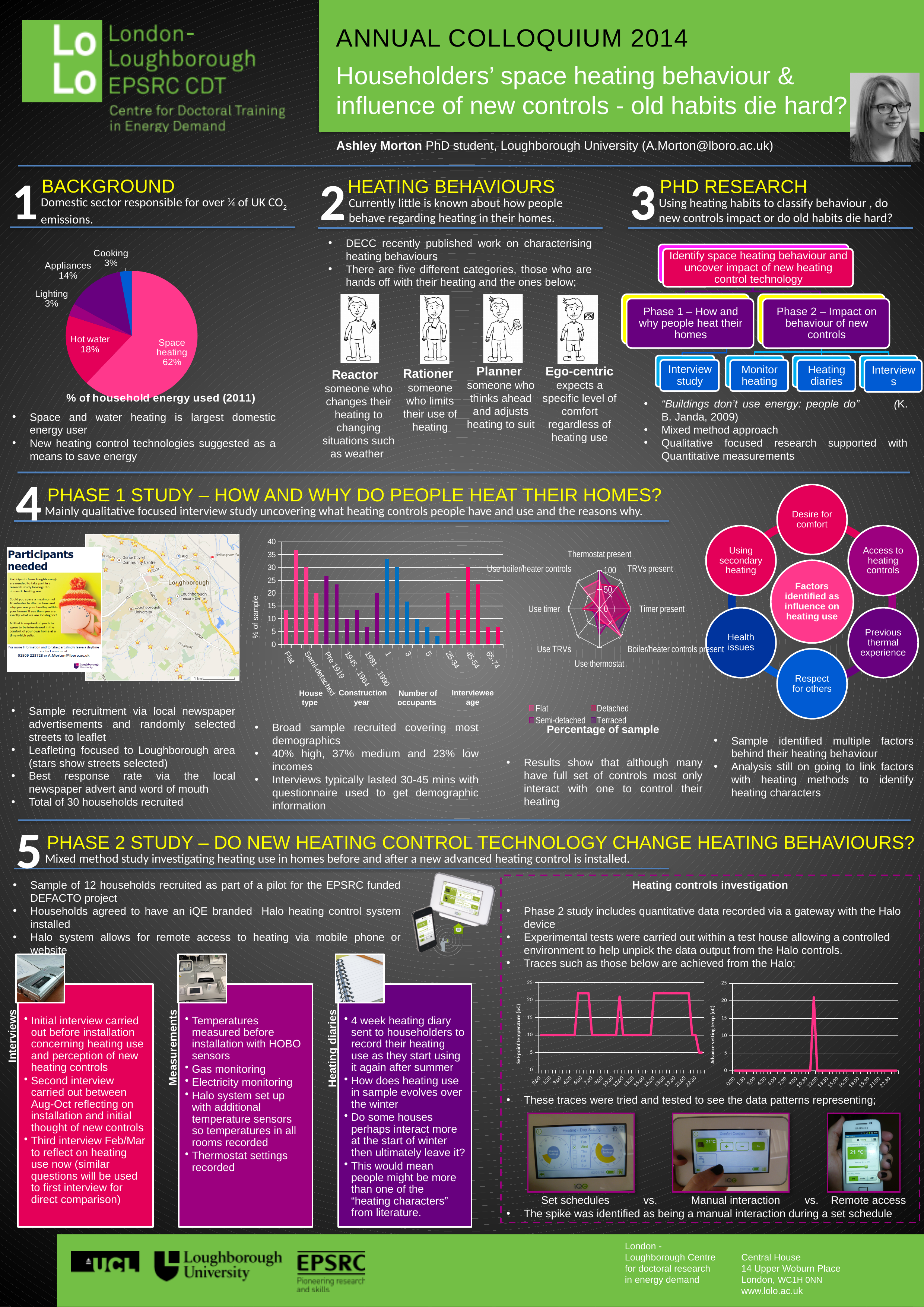
What kind of chart is the '% of household energy used (2011)' chart? Pie chart What is the y-axis label of the bar chart in the Phase 1 section? % of sample In the pie chart '% of household energy used (2011)', what is the combined share of Space heating and Hot water? 80% In the pie chart '% of household energy used (2011)', how many percentage points larger is Space heating than Hot water? 44% How many slices does the pie chart '% of household energy used (2011)' have? 5 In the pie chart '% of household energy used (2011)', what share is Space heating? 62% What kind of chart is the 'Percentage of sample' chart in the Phase 1 section? Radar chart In the pie chart '% of household energy used (2011)', what share is Hot water? 18% In the pie chart '% of household energy used (2011)', what share is Appliances? 14% In the pie chart '% of household energy used (2011)', which category has the largest share? Space heating In the pie chart '% of household energy used (2011)', which is larger, Hot water or Appliances? Hot water How many series does the legend of the 'Percentage of sample' radar chart list? 4